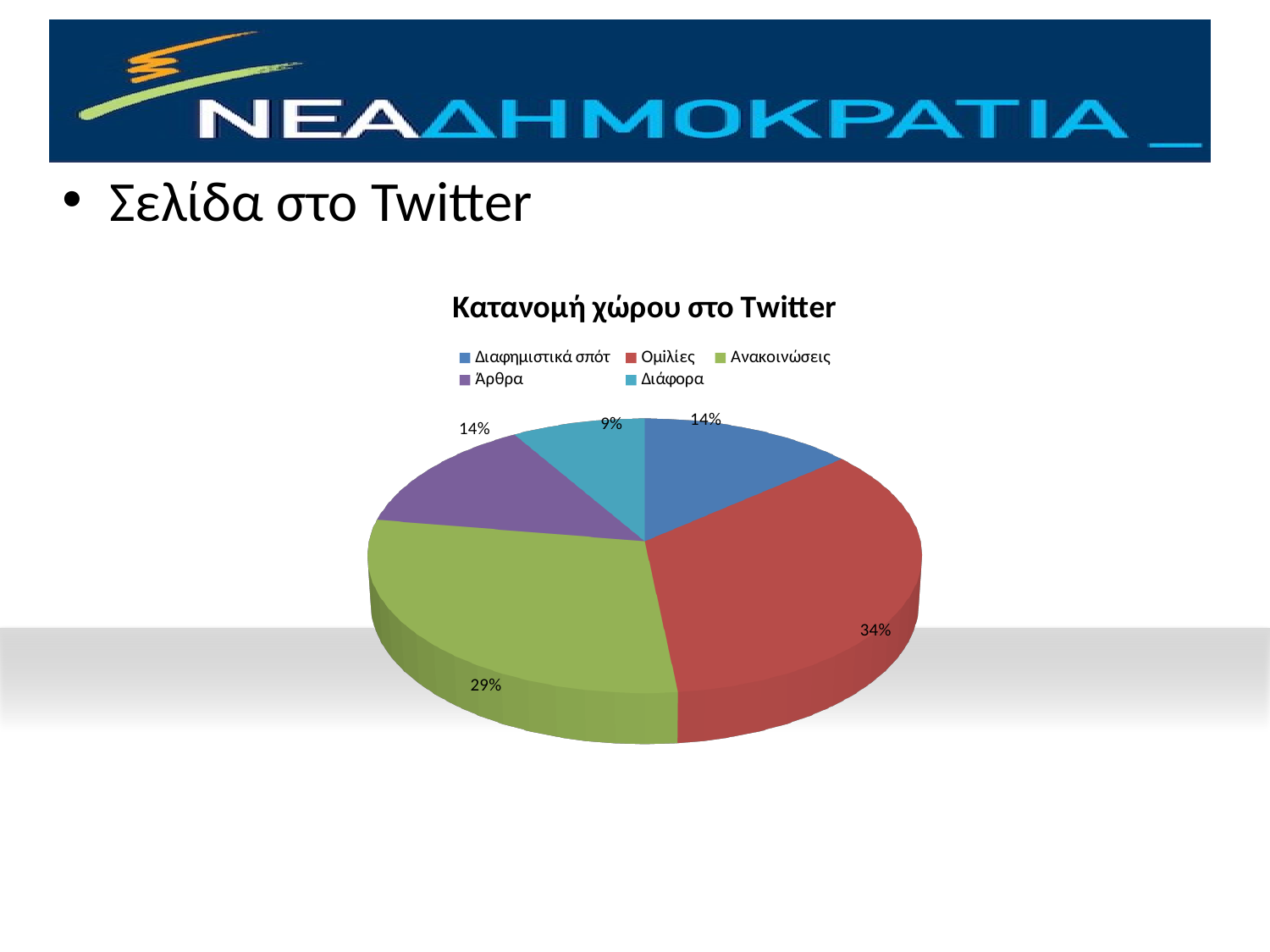
What is the title of the chart? Κατανομή χώρου στο Twitter What share of the pie does Ομιλίες have? 34% What is the difference in percentage points between Ομιλίες and Ανακοινώσεις? 5 Which is larger, the share for Άρθρα or the share for Διάφορα? Άρθρα What share of the pie does Διάφορα have? 9% Which category has the smallest share of the pie? Διάφορα Which category has the largest share of the pie? Ομιλίες How many categories does the legend of the chart list? 5 Which colour represents Ανακοινώσεις in the chart? Green What type of chart is shown on the slide? Pie chart What share of the pie does Διαφημιστικά σποτ have? 14%